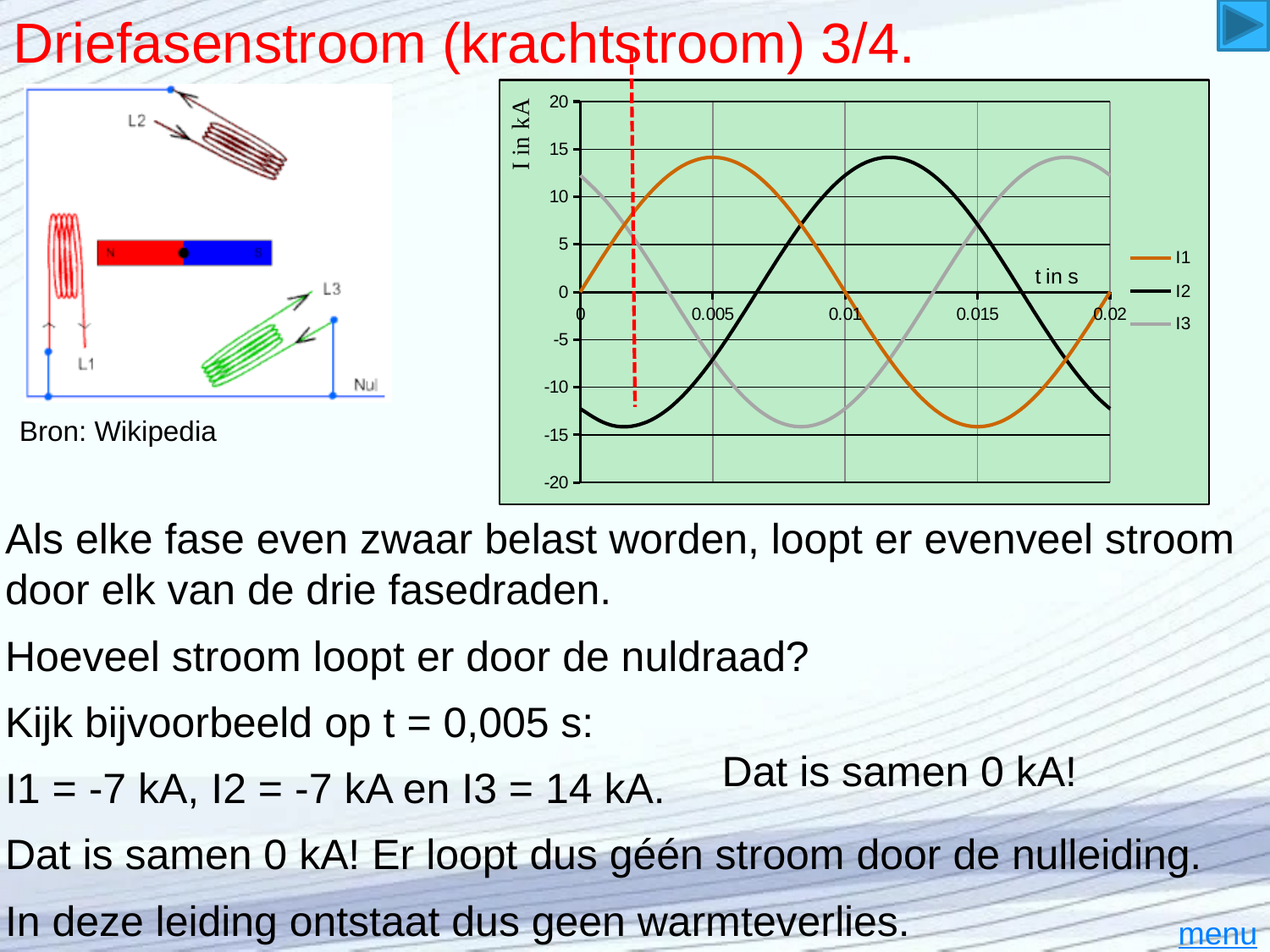
At t = 0.005 s, is the value of I1 greater or less than 10? greater At t = 0.005 s, is the value of I2 greater or less than 0? less At t = 0.005 s, is the value of I3 greater or less than -5? less Does the value of I1 rise or fall between t = 0 s and t = 0.005 s? rise At t = 0.005 s, which series has the highest value? I1 How many series does the chart's legend list? 3 What kind of chart is shown on the slide? line chart What is the label of the chart's vertical axis? I in kA What are the series names listed in the chart's legend? I1, I2, I3 At t = 0 s, which is larger, I2 or I3? I3